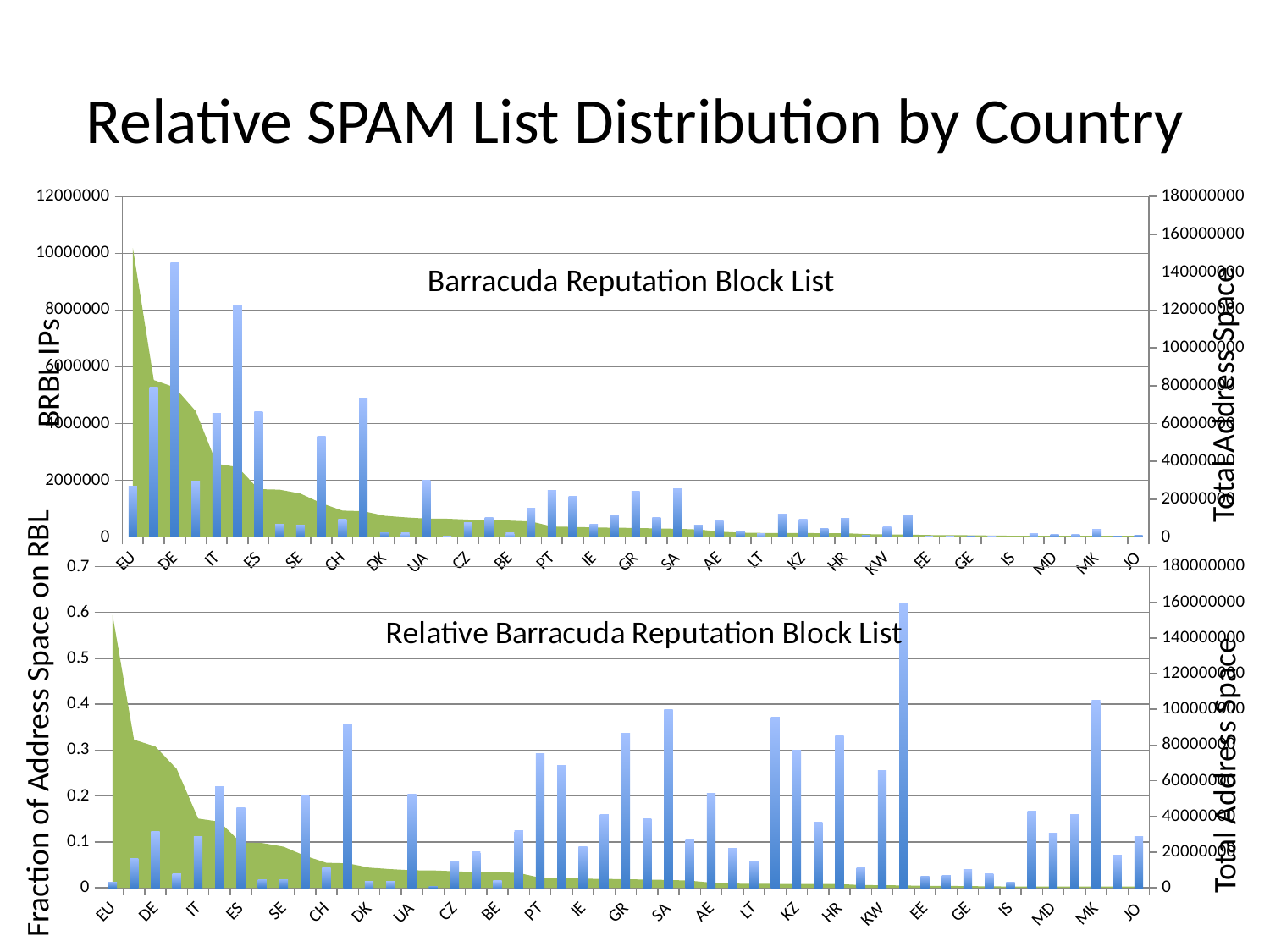
In the top chart, does the green Total Address Space area generally rise or fall from left to right? fall In the top chart, is the BRBL IPs value for JO greater or less than 2000000? less What is the title of the bottom chart? Relative Barracuda Reputation Block List In the top chart, which country has the highest BRBL IPs value? DE In the bottom chart, is the fraction of address space on RBL for EU greater or less than 0.1? less In the top chart, is the BRBL IPs value for DE greater or less than 8000000? greater What is the title of the top chart? Barracuda Reputation Block List In the top chart, which has the larger BRBL IPs value, DE or IT? DE What is the maximum value shown on the left axis of the bottom chart? 0.7 In the top chart, what kind of chart is used to plot the BRBL IPs values? bar chart